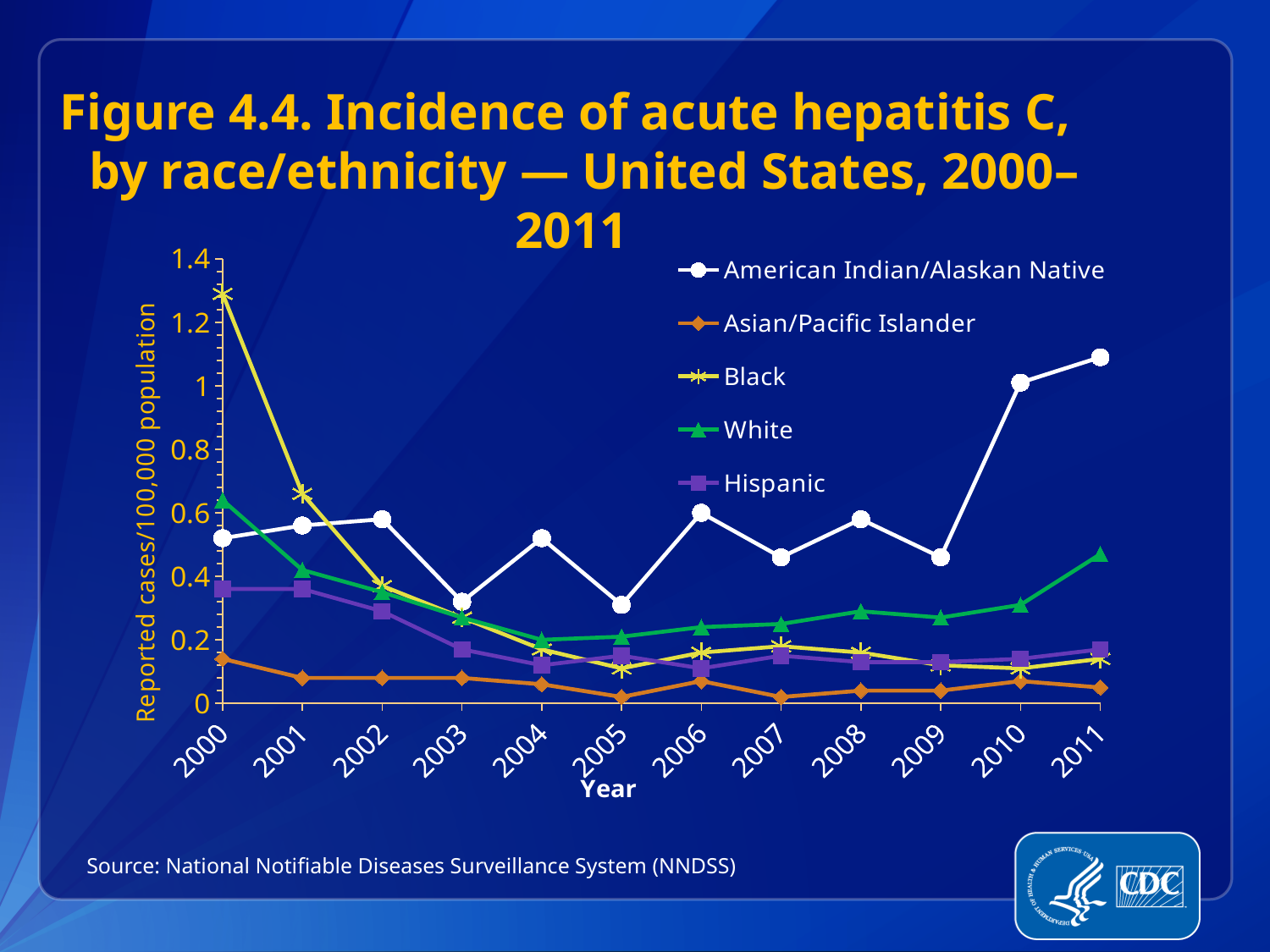
Is the value for White in 2011 greater or less than 0.6? less How many years are plotted along the x axis? 12 Which race/ethnicity group has the highest incidence in 2011? American Indian/Alaskan Native How many series does the legend list? 5 What is the label on the y axis? Reported cases/100,000 population Does the incidence for Black rise or fall from 2000 to 2005? Fall In 2011, which is larger: the value for White or the value for Hispanic? White Is the value for American Indian/Alaskan Native in 2011 greater or less than 1? greater Which race/ethnicity group has the lowest incidence in 2005? Asian/Pacific Islander Which race/ethnicity group has the highest incidence in 2000? Black Is the value for Black in 2000 greater or less than 1? greater What kind of chart is shown on the slide? Line chart